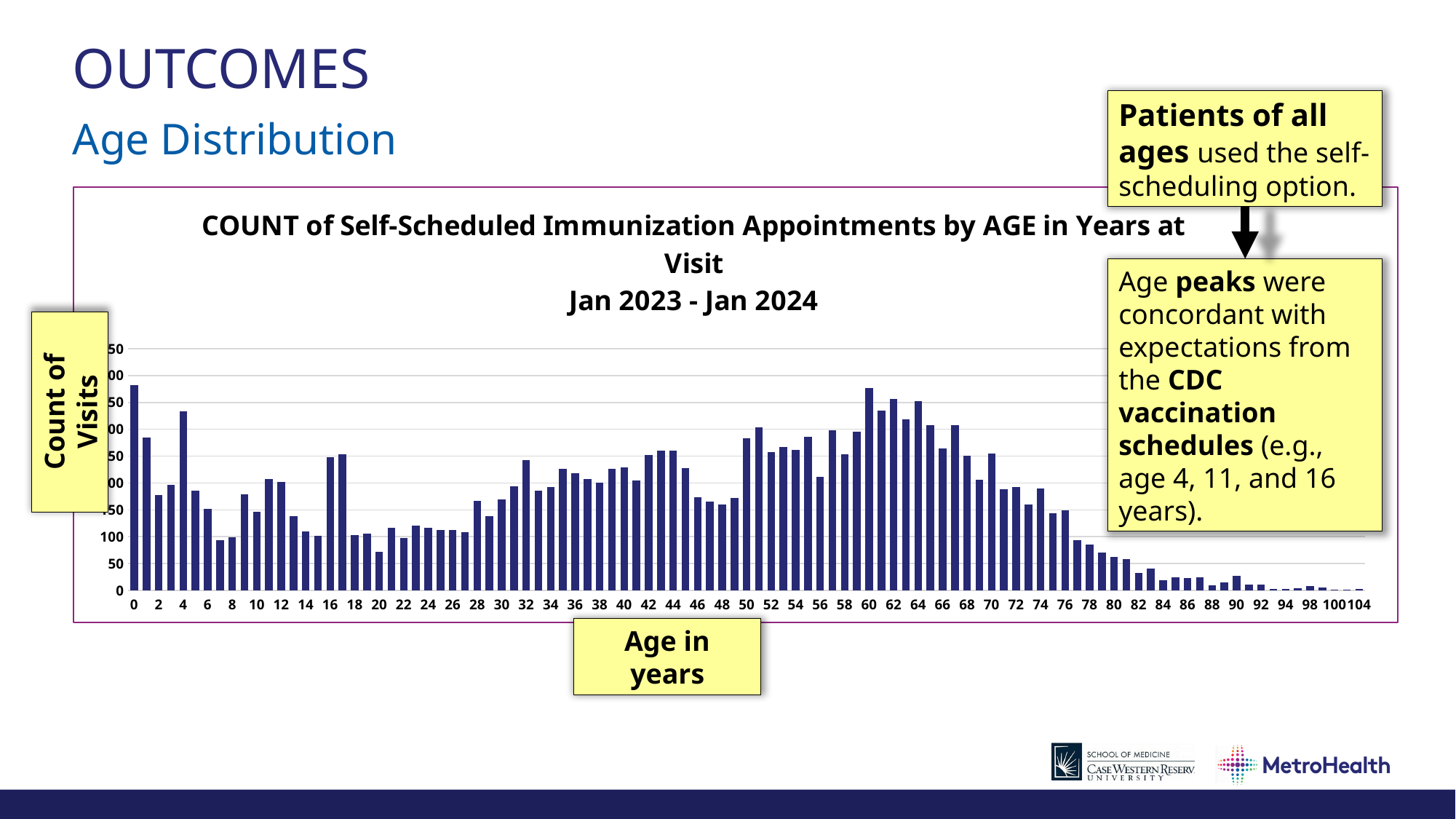
What does the y axis of the chart represent, according to the yellow label? Count of Visits Is the count of visits for age 50 greater or less than 100? greater Is the count of visits for age 84 greater or less than 50? less Do the counts of visits generally rise or fall as age increases from 76 to 104? Fall Which age has a higher count of visits, age 62 or age 80? Age 62 Which age has a higher count of visits, age 4 or age 6? Age 4 Is the count of visits for age 0 greater or less than 100? greater Which age has a higher count of visits, age 16 or age 20? Age 16 What kind of chart is shown on the slide? Bar chart What is the title of the chart? COUNT of Self-Scheduled Immunization Appointments by AGE in Years at Visit Jan 2023 - Jan 2024